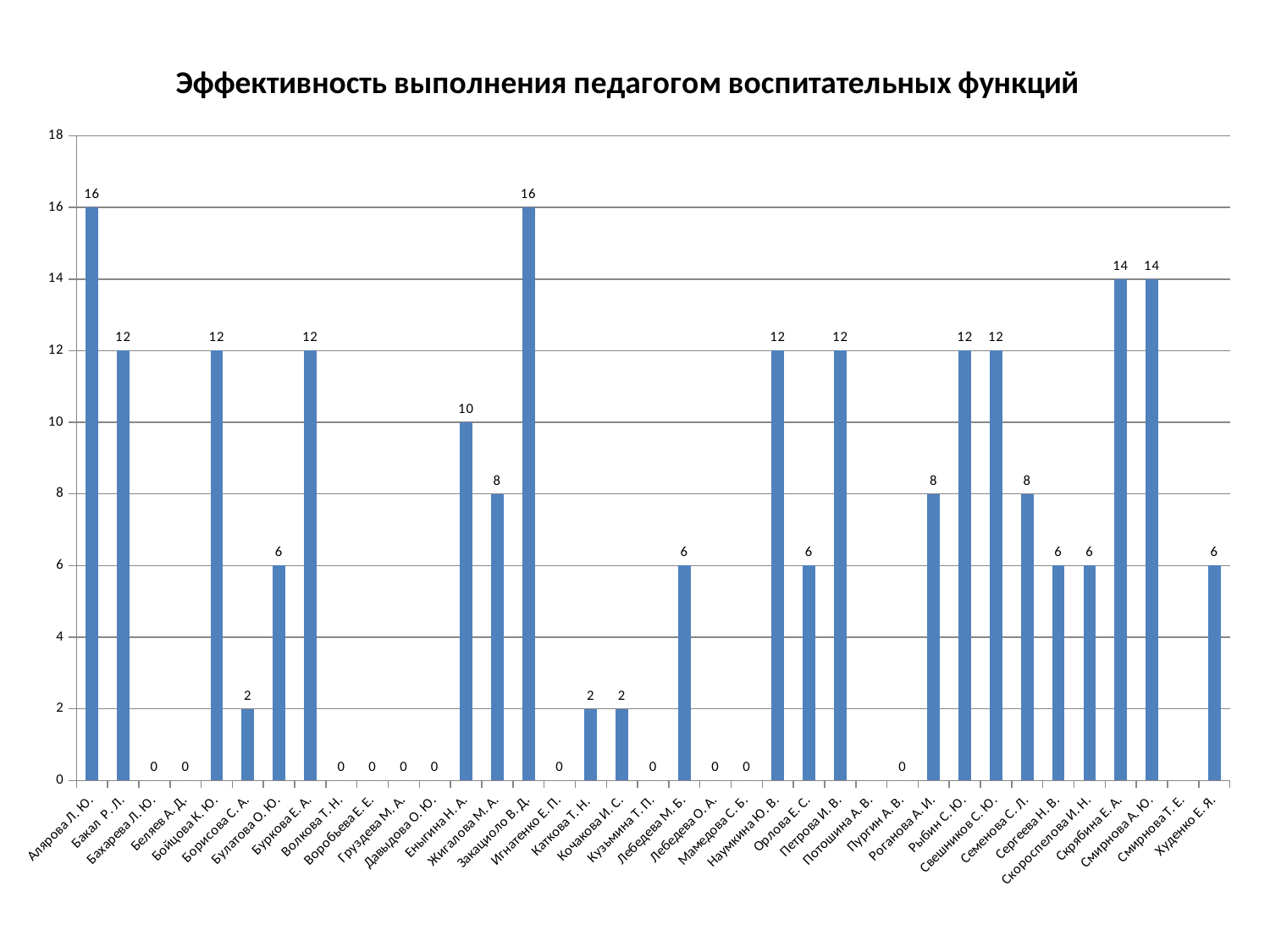
What is the value for Скрябина Е. А.? 14 What is the value for Наумкина Ю. В.? 12 What is the title of the chart? Эффективность выполнения педагогом воспитательных функций What is the difference between the values for Закациоло В. Д. and Жигалова М. А.? 8 What is the difference between the values for Смирнова А. Ю. and Сергеева Н. В.? 8 What is the value for Еныгина Н. А.? 10 What is the value for Волкова Т. Н.? 0 What is the value for Борисова С. А.? 2 Which has a larger value, Роганова А. И. or Орлова Е. С.? Роганова А. И. What kind of chart is shown on the slide? bar chart What is the value for Худенко Е. Я.? 6 What is the highest value shown in the chart? 16